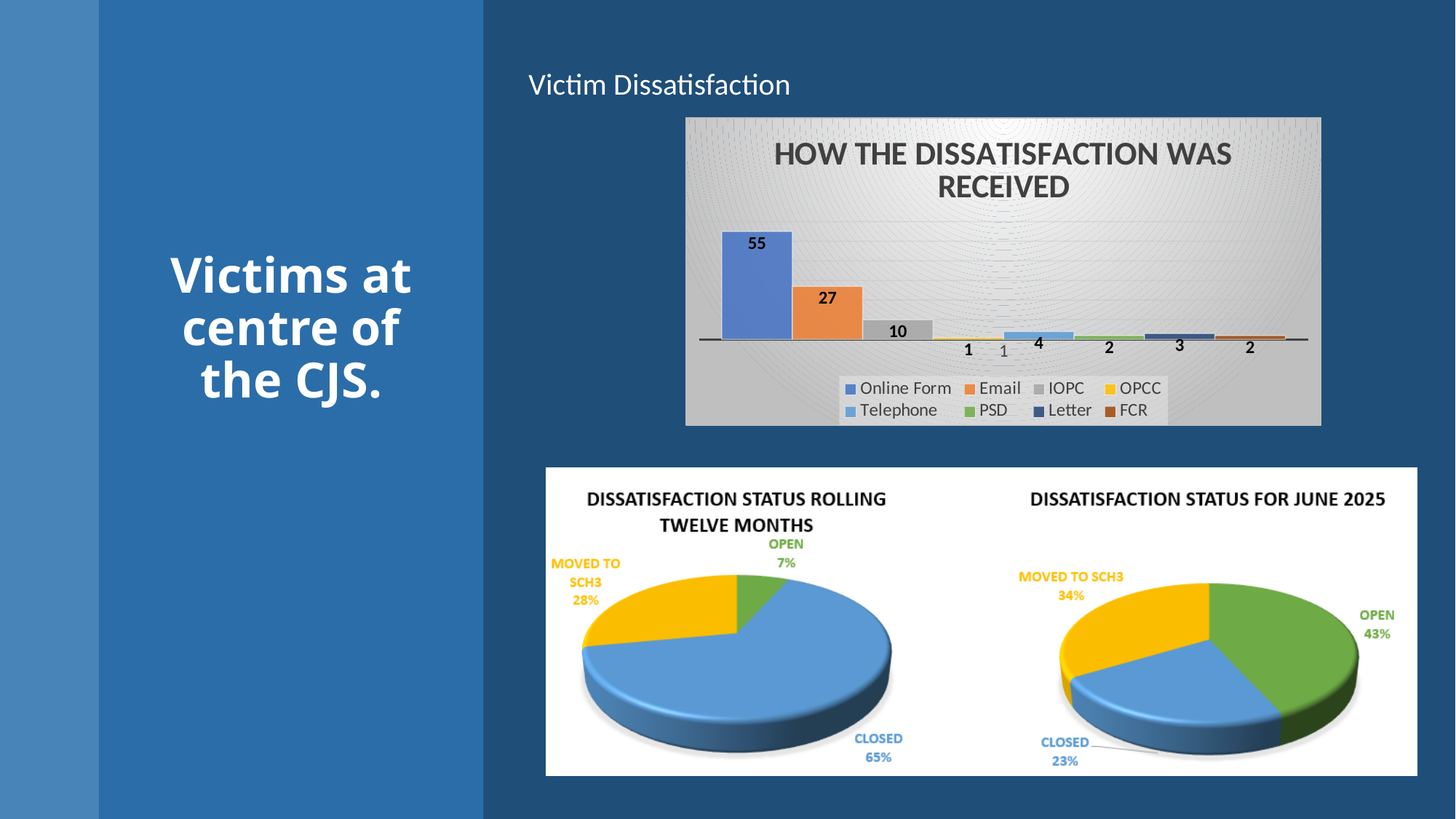
In the 'How the Dissatisfaction Was Received' chart, which category has the highest value? Online Form In the 'Dissatisfaction Status Rolling Twelve Months' pie chart, what share is Closed? 65% In the 'How the Dissatisfaction Was Received' chart, what is the value for Online Form? 55 In the 'How the Dissatisfaction Was Received' chart, what is the value for Email? 27 How many entries does the legend of the 'How the Dissatisfaction Was Received' chart list? 8 In the 'Dissatisfaction Status for June 2025' pie chart, which status has the largest share? Open What kind of chart is 'How the Dissatisfaction Was Received'? Bar chart In the 'Dissatisfaction Status Rolling Twelve Months' pie chart, what share is Moved to SCH3? 28% In the 'How the Dissatisfaction Was Received' chart, which is larger, IOPC or Telephone? IOPC In the 'How the Dissatisfaction Was Received' chart, what is the value for Letter? 3 In the 'Dissatisfaction Status for June 2025' pie chart, what share is Closed? 23% In the 'How the Dissatisfaction Was Received' chart, what is the difference between the Online Form and Email values? 28